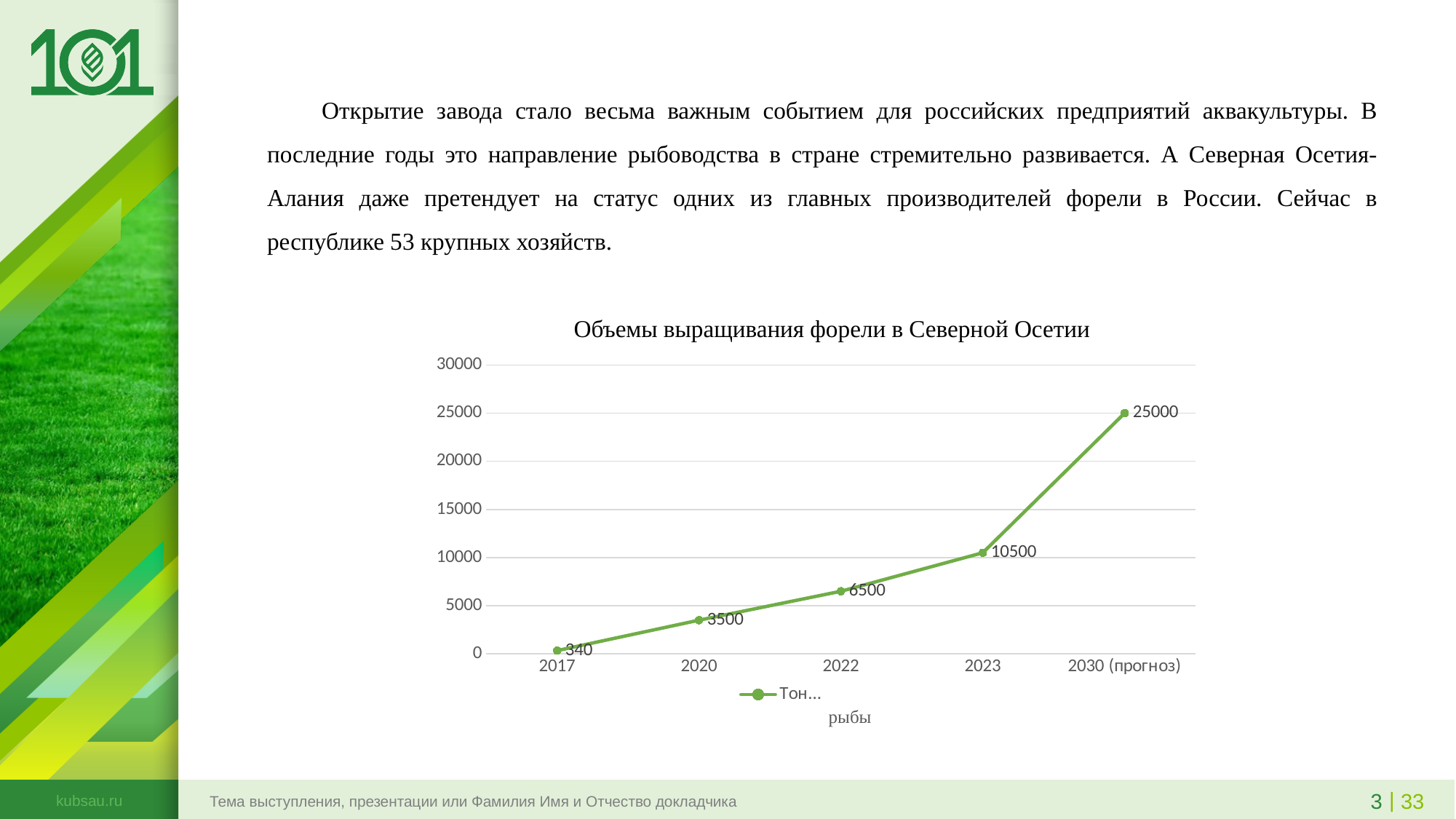
What kind of chart is shown on the slide? line chart What is the value for 2022 in the chart? 6500 What is the value for 2023 in the chart? 10500 Which category has the lowest value in the chart? 2017 How many data points are plotted in the chart? 5 What is the difference between the values for 2030 (прогноз) and 2023? 14500 Which category has the highest value in the chart? 2030 (прогноз) What is the value for 2020 in the chart? 3500 Which is larger, the value for 2022 or the value for 2020? 2022 What is the value for 2030 (прогноз) in the chart? 25000 Do the values rise or fall from 2017 to 2030 (прогноз)? rise What is the value for 2017 in the chart? 340